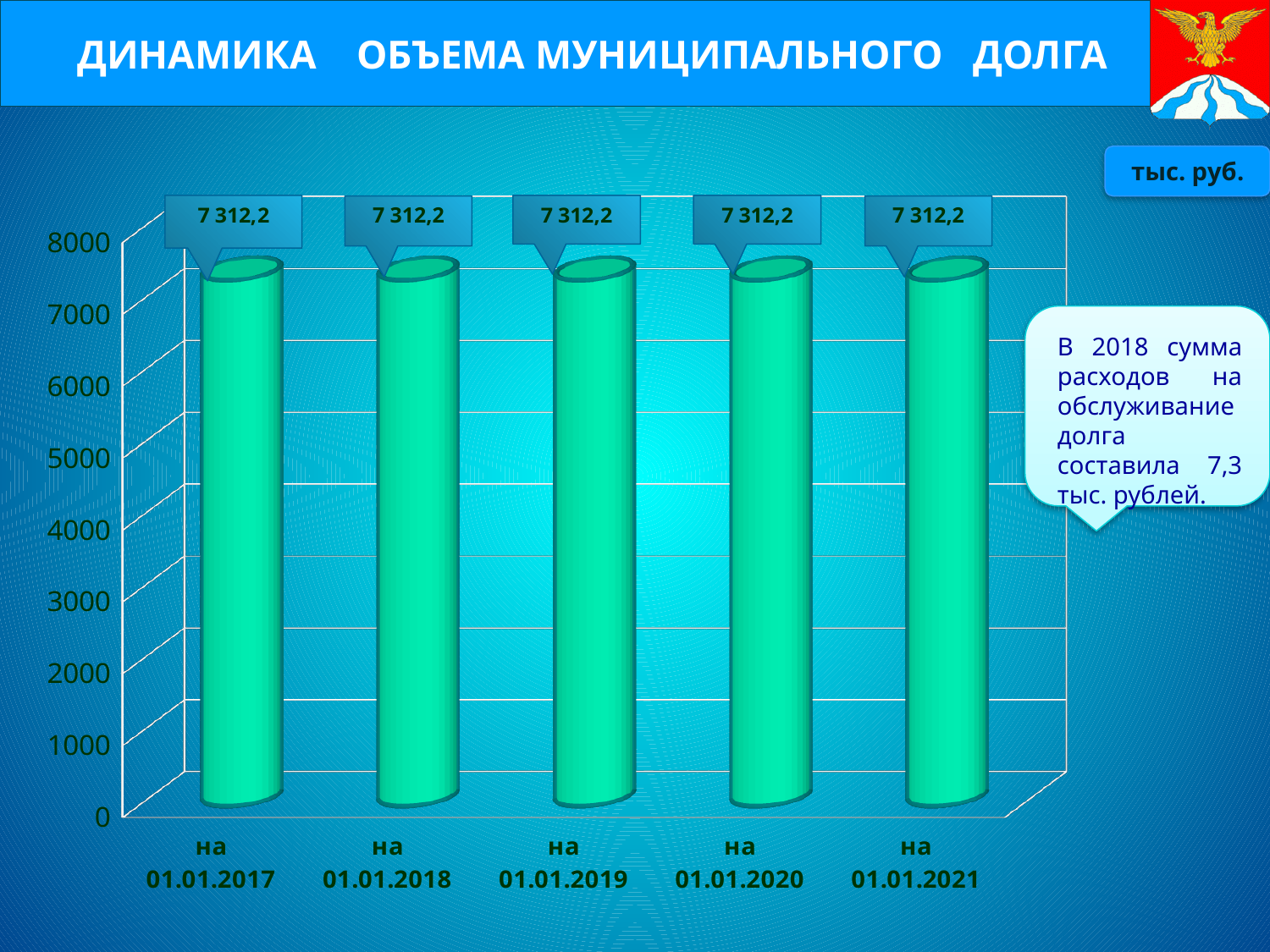
What is the difference between the values for на 01.01.2018 and на 01.01.2021? 0 What is the value for на 01.01.2019? 7 312,2 What is the value for на 01.01.2021? 7 312,2 What is the value for на 01.01.2017? 7 312,2 Is the value for на 01.01.2020 greater or less than 8000? less What kind of chart is shown on the slide? bar chart What is the value for на 01.01.2020? 7 312,2 What is the title of the chart? ДИНАМИКА ОБЪЕМА МУНИЦИПАЛЬНОГО ДОЛГА In what units are the chart values given? тыс. руб. Is the value for на 01.01.2018 greater or less than 7000? greater How many categories (dates) are shown on the x axis? 5 Do the values rise, fall or stay the same from на 01.01.2017 to на 01.01.2021? stay the same